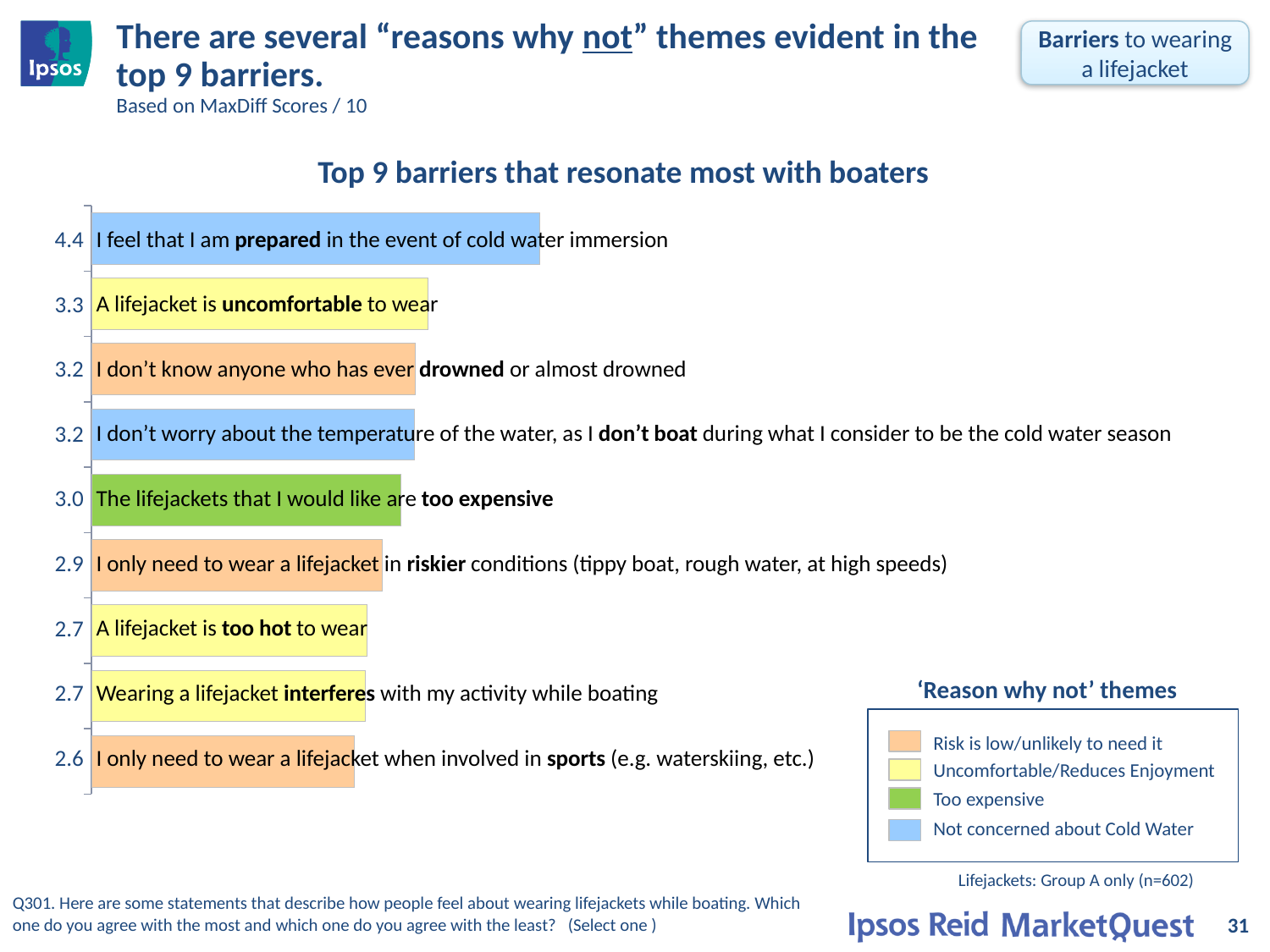
What is the difference between the score for "I feel that I am prepared in the event of cold water immersion" and the score for "A lifejacket is uncomfortable to wear"? 1.1 Which barrier has the lowest score in the chart? I only need to wear a lifejacket when involved in sports (e.g. waterskiing, etc.) What is the score for "The lifejackets that I would like are too expensive"? 3.0 Which has a higher score: "The lifejackets that I would like are too expensive" or "A lifejacket is too hot to wear"? The lifejackets that I would like are too expensive What is the score for "A lifejacket is uncomfortable to wear"? 3.3 What is the score for "I only need to wear a lifejacket when involved in sports (e.g. waterskiing, etc.)"? 2.6 How many 'Reason why not' themes does the legend list? 4 Which theme does the green colour represent in the legend? Too expensive Which barrier has the highest score in the chart? I feel that I am prepared in the event of cold water immersion How many barriers are shown in the chart? 9 What type of chart is shown on the slide? Bar chart What is the MaxDiff score for "I feel that I am prepared in the event of cold water immersion"? 4.4